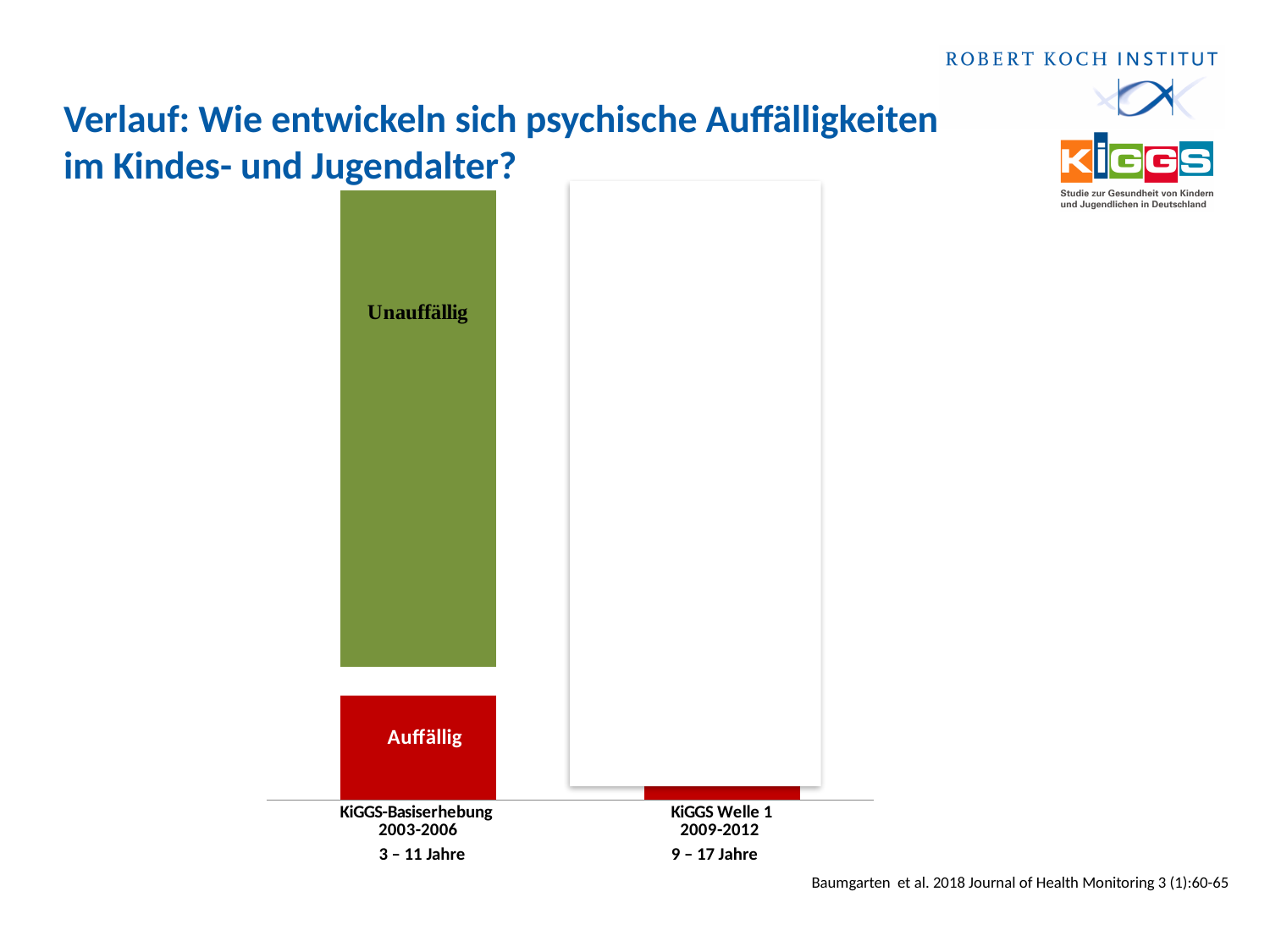
How many labelled segments (series) make up the stacked bar for KiGGS-Basiserhebung 2003-2006? 2 What colour is the Auffällig segment in the chart? red In the KiGGS-Basiserhebung 2003-2006 bar, which segment is larger, Unauffällig or Auffällig? Unauffällig Which age range is given under the KiGGS Welle 1 2009-2012 category? 9 – 17 Jahre What kind of chart is shown on the slide? stacked bar chart How many categories are shown along the x axis of the chart? 2